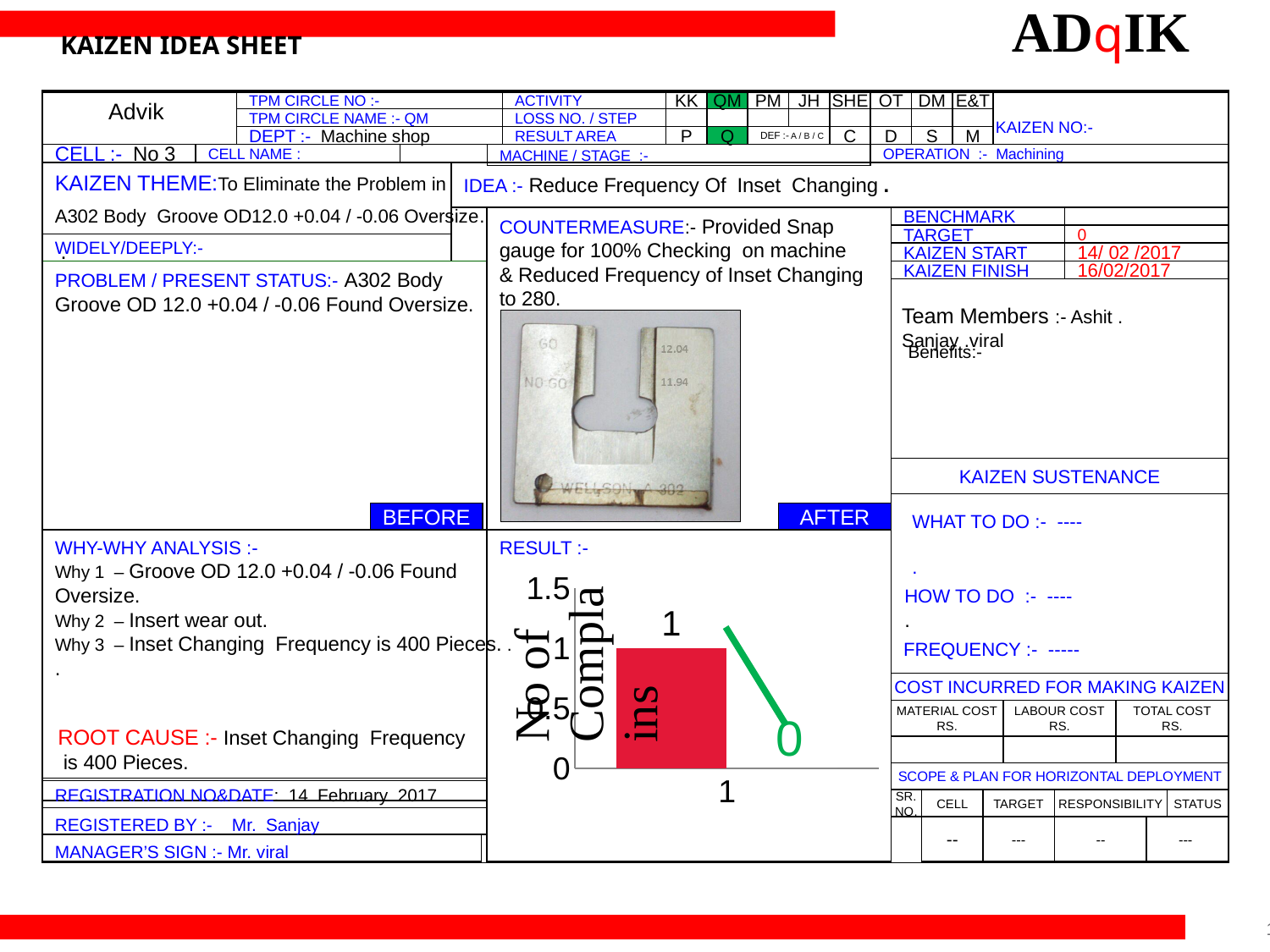
In the RESULT chart, what is the highest tick value shown on the vertical axis? 1.5 In the RESULT chart, what value is printed on the red bar? 1 What kind of chart is shown in the RESULT section of the slide? bar chart In the RESULT chart, what is the title of the vertical axis? No of Complains In the RESULT chart, is the value of the red bar greater or less than 1.5? less In the RESULT chart, what category label appears on the horizontal axis? 1 In the RESULT chart, is the value of the red bar greater or less than 0.5? greater How many bars are plotted in the RESULT chart? 1 In the RESULT chart, what value is printed in green at the lower end of the green line? 0